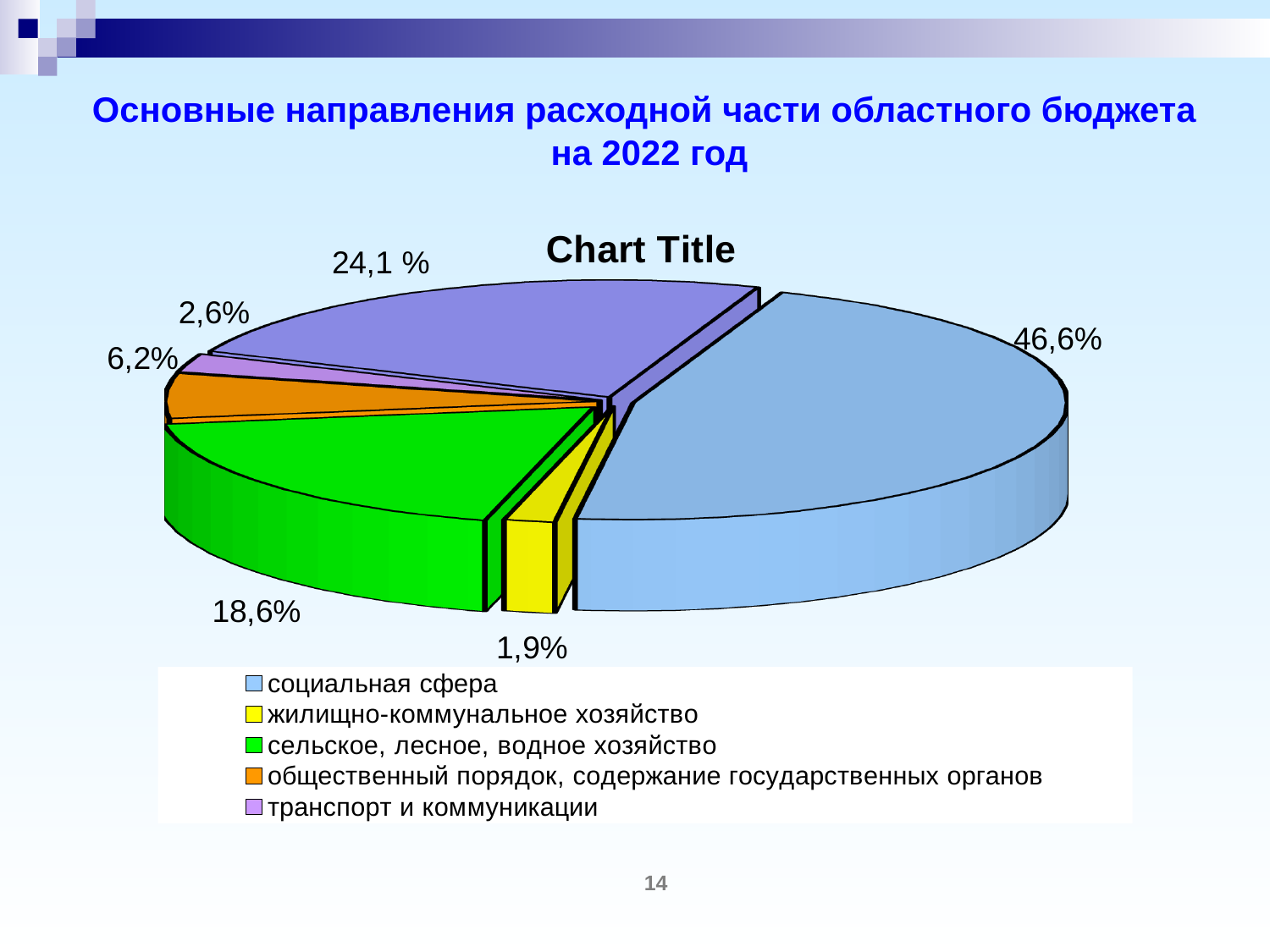
Which category has the largest slice of the pie? социальная сфера Which category has the smallest slice of the pie? жилищно-коммунальное хозяйство How many entries does the legend list? 5 What is the difference between the shares of социальная сфера and сельское, лесное, водное хозяйство? 28,0% What is the value shown for транспорт и коммуникации? 2,6% What is the value shown for жилищно-коммунальное хозяйство? 1,9% What share of the pie does социальная сфера have? 46,6% What is the title printed above the pie chart? Chart Title What is the value shown for общественный порядок, содержание государственных органов? 6,2% What is the value shown for сельское, лесное, водное хозяйство? 18,6% What kind of chart is shown on the slide? pie chart Which is larger: the share of общественный порядок, содержание государственных органов or the share of транспорт и коммуникации? общественный порядок, содержание государственных органов